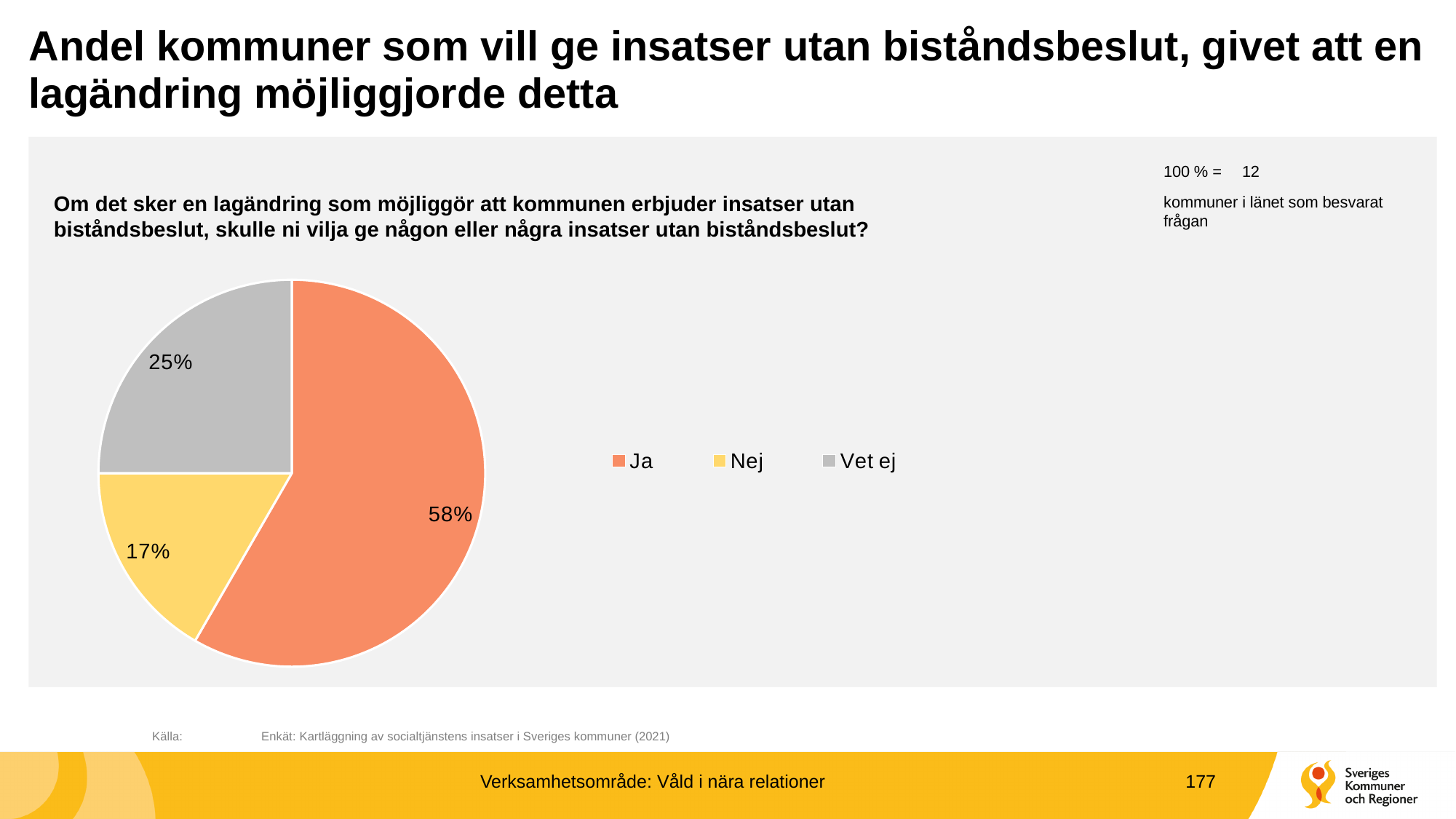
Which is larger, the "Vet ej" slice or the "Nej" slice? Vet ej What share of the pie does "Ja" represent? 58% What colour is the "Ja" slice in the pie chart? orange What kind of chart is shown on the slide? pie chart How many entries does the legend list? 3 What share of the pie does "Vet ej" represent? 25% What is the difference in percentage points between the "Vet ej" slice and the "Nej" slice? 8 Which category has the smallest slice of the pie? Nej What is the difference in percentage points between the "Ja" slice and the "Vet ej" slice? 33 What share of the pie does "Nej" represent? 17% Which category has the largest slice of the pie? Ja How many categories does the pie chart have? 3